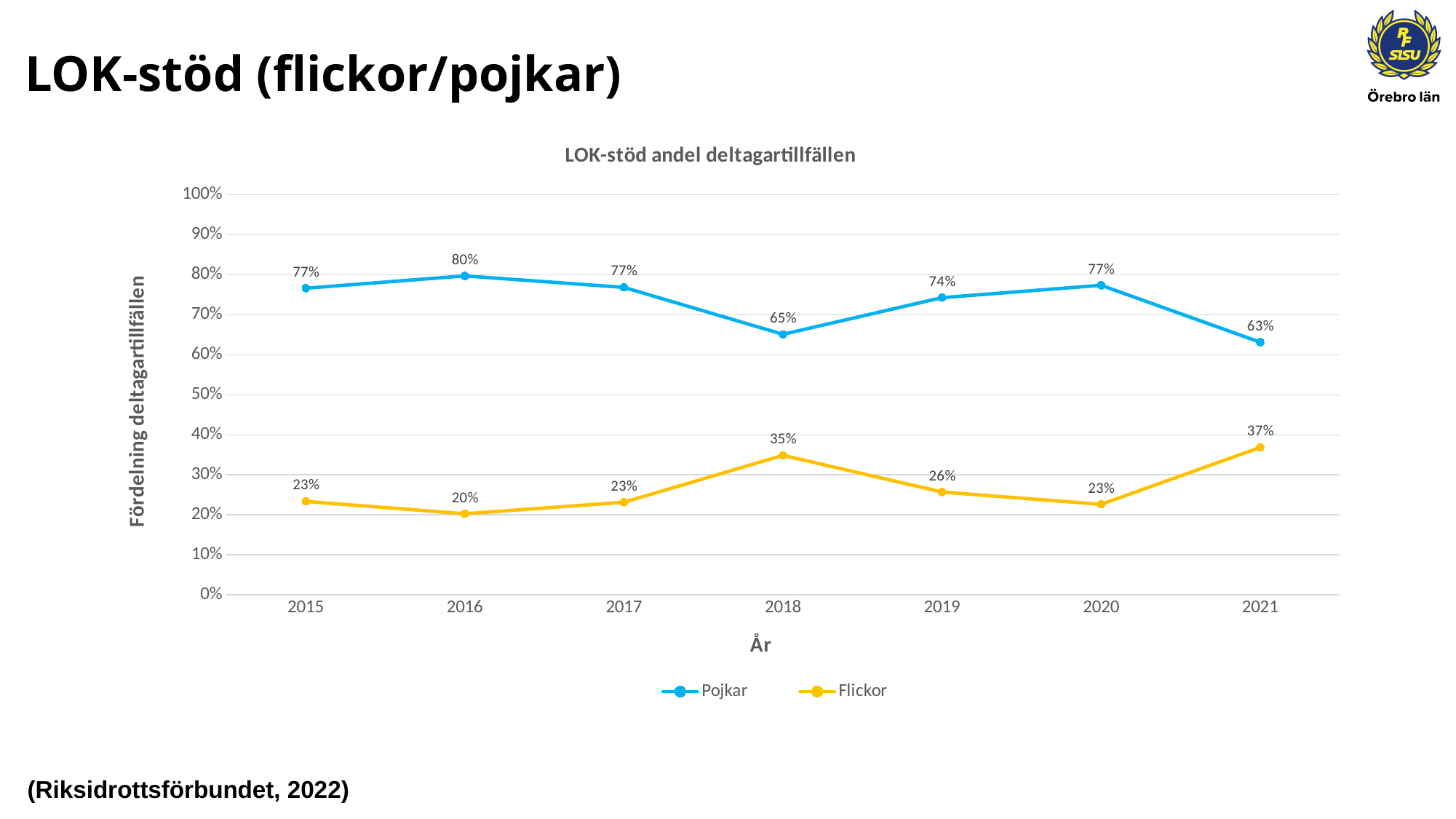
How many years are shown on the x axis? 7 How many series does the legend list? 2 Does the Pojkar value rise or fall from 2020 to 2021? fall Which is larger, the Flickor value in 2018 or the Flickor value in 2019? 2018 What is the difference between the Pojkar and Flickor values in 2021? 26% What is the title of the chart? LOK-stöd andel deltagartillfällen What is the value for Flickor in 2016? 20% In which year is the Flickor value lowest? 2016 What is the value for Pojkar in 2018? 65% What is the value for Flickor in 2021? 37% In which year is the Pojkar value highest? 2016 What kind of chart is shown? line chart